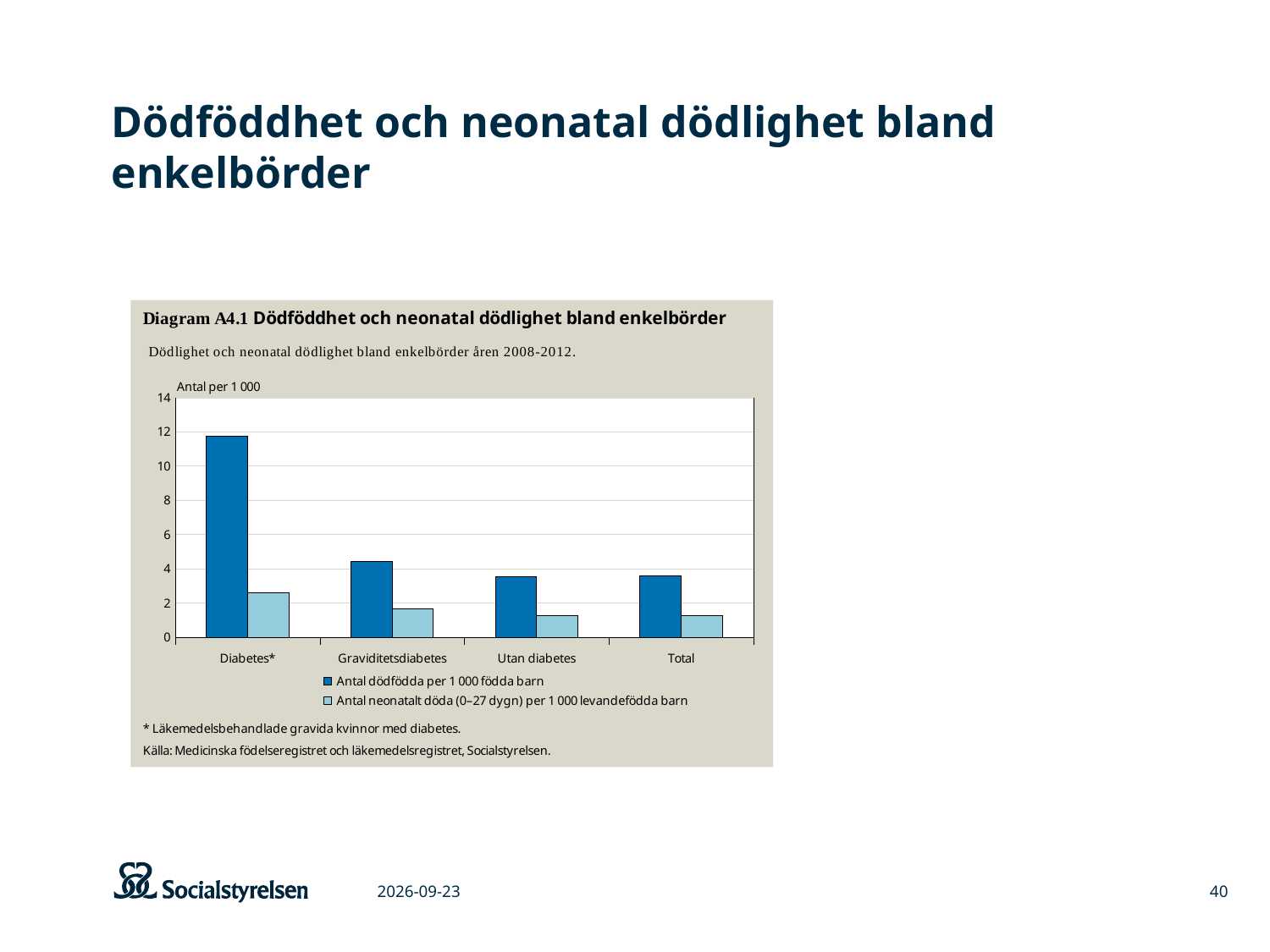
Which category has the highest value for Antal neonatalt döda (0–27 dygn) per 1 000 levandefödda barn? Diabetes* Is the value for Antal dödfödda per 1 000 födda barn for Graviditetsdiabetes greater or less than 6? less What is the label on the y axis of the chart? Antal per 1 000 For the Total category, which series has the larger value: Antal dödfödda per 1 000 födda barn or Antal neonatalt döda (0–27 dygn) per 1 000 levandefödda barn? Antal dödfödda per 1 000 födda barn How many categories are shown on the x axis of the chart? 4 Is the value for Antal neonatalt döda (0–27 dygn) per 1 000 levandefödda barn for Utan diabetes greater or less than 2? less What kind of chart is shown on the slide? Bar chart Which years does the chart's subtitle say the data covers? 2008-2012 Which is larger for Antal dödfödda per 1 000 födda barn: Diabetes* or Graviditetsdiabetes? Diabetes* Is the value for Antal dödfödda per 1 000 födda barn for Diabetes* greater or less than 10? greater How many series does the chart's legend list? 2 Which category has the highest value for Antal dödfödda per 1 000 födda barn? Diabetes*